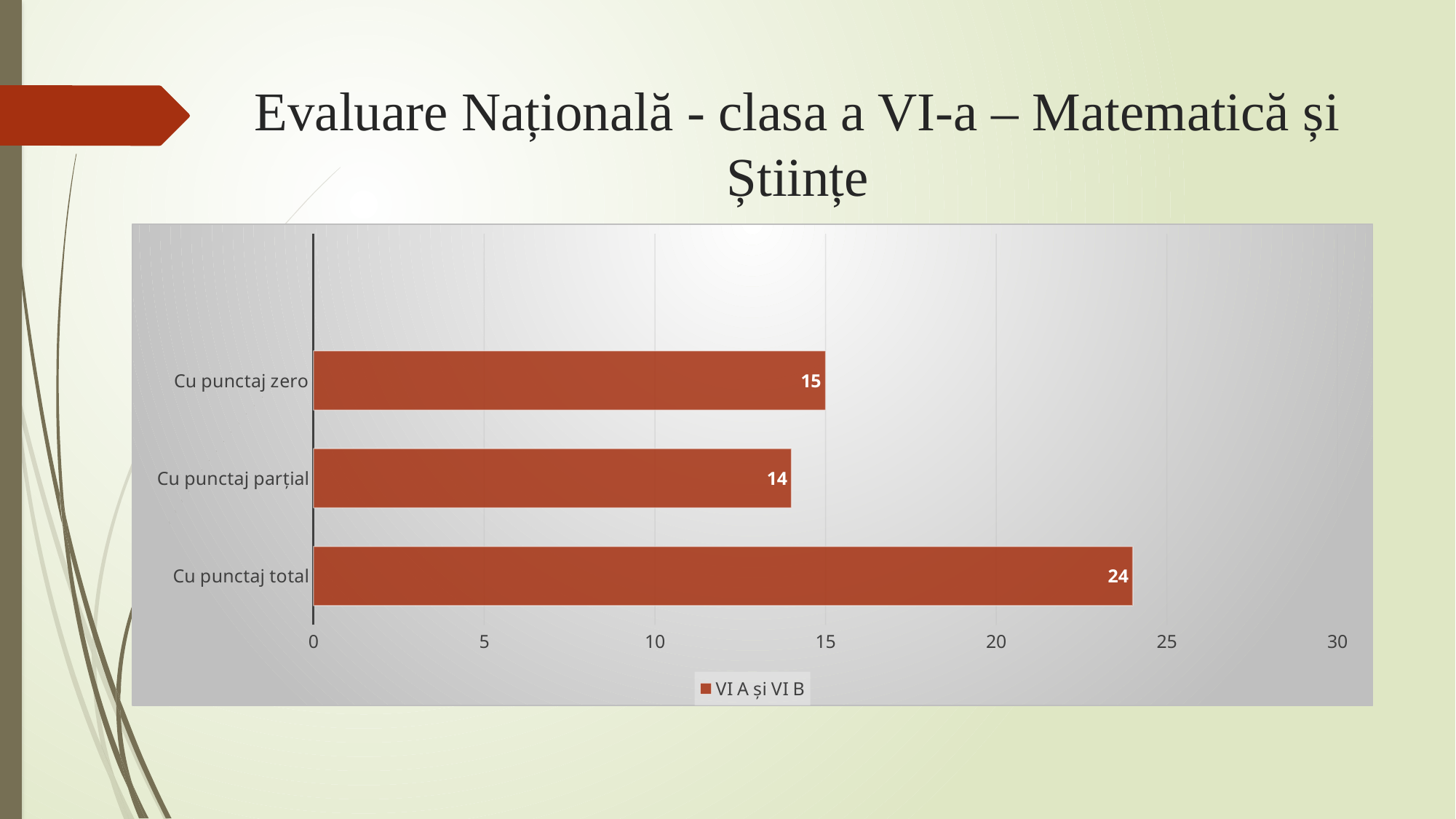
Is the value for "Cu punctaj total" greater or less than 20? greater Which category has the highest value? Cu punctaj total Which category has the lowest value? Cu punctaj parțial What is the difference between the values for "Cu punctaj zero" and "Cu punctaj parțial"? 1 Which is larger, the value for "Cu punctaj total" or the value for "Cu punctaj parțial"? Cu punctaj total What is the value for "Cu punctaj parțial"? 14 What is the difference between the values for "Cu punctaj total" and "Cu punctaj zero"? 9 What kind of chart is shown on the slide? bar chart What is the value for "Cu punctaj zero"? 15 What is the value for "Cu punctaj total"? 24 How many categories are shown in the chart? 3 What series name does the legend show? VI A și VI B